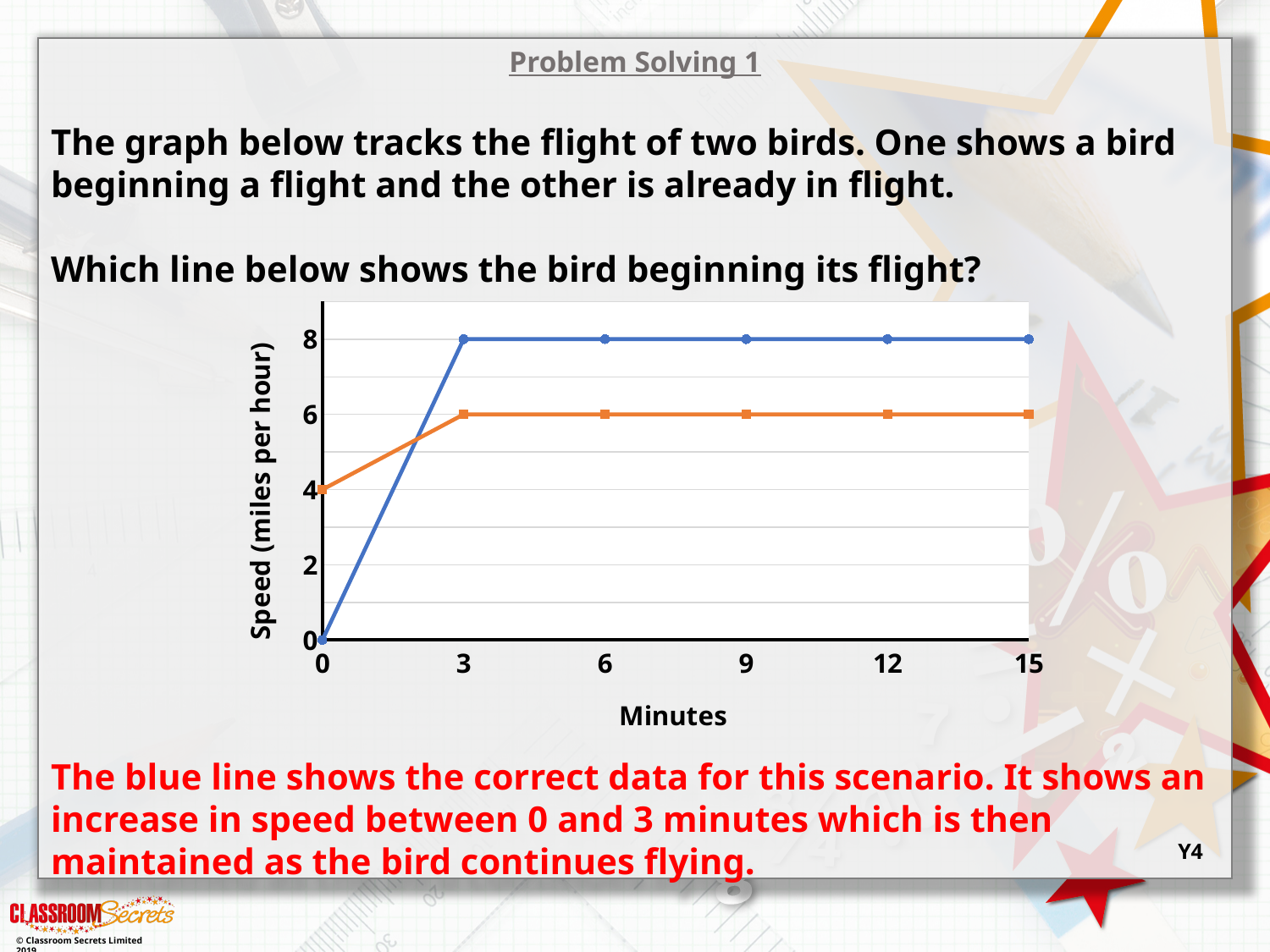
How many lines are plotted on the chart? 2 At 0 minutes, which line shows the higher speed, blue or orange? orange At 9 minutes, which line shows the higher speed, blue or orange? blue What kind of chart is shown on the slide? line chart Does the blue line rise, fall or stay flat between 3 and 15 minutes? stays flat What is the speed shown by the orange line at 0 minutes? 4 What is the difference in speed between the blue line and the orange line at 12 minutes? 2 What is the speed shown by the blue line at 0 minutes? 0 What is the speed shown by the blue line at 3 minutes? 8 What is the label on the y axis of the chart? Speed (miles per hour) How many points along the x axis (Minutes) are plotted for each line? 6 What is the speed shown by the orange line at 15 minutes? 6